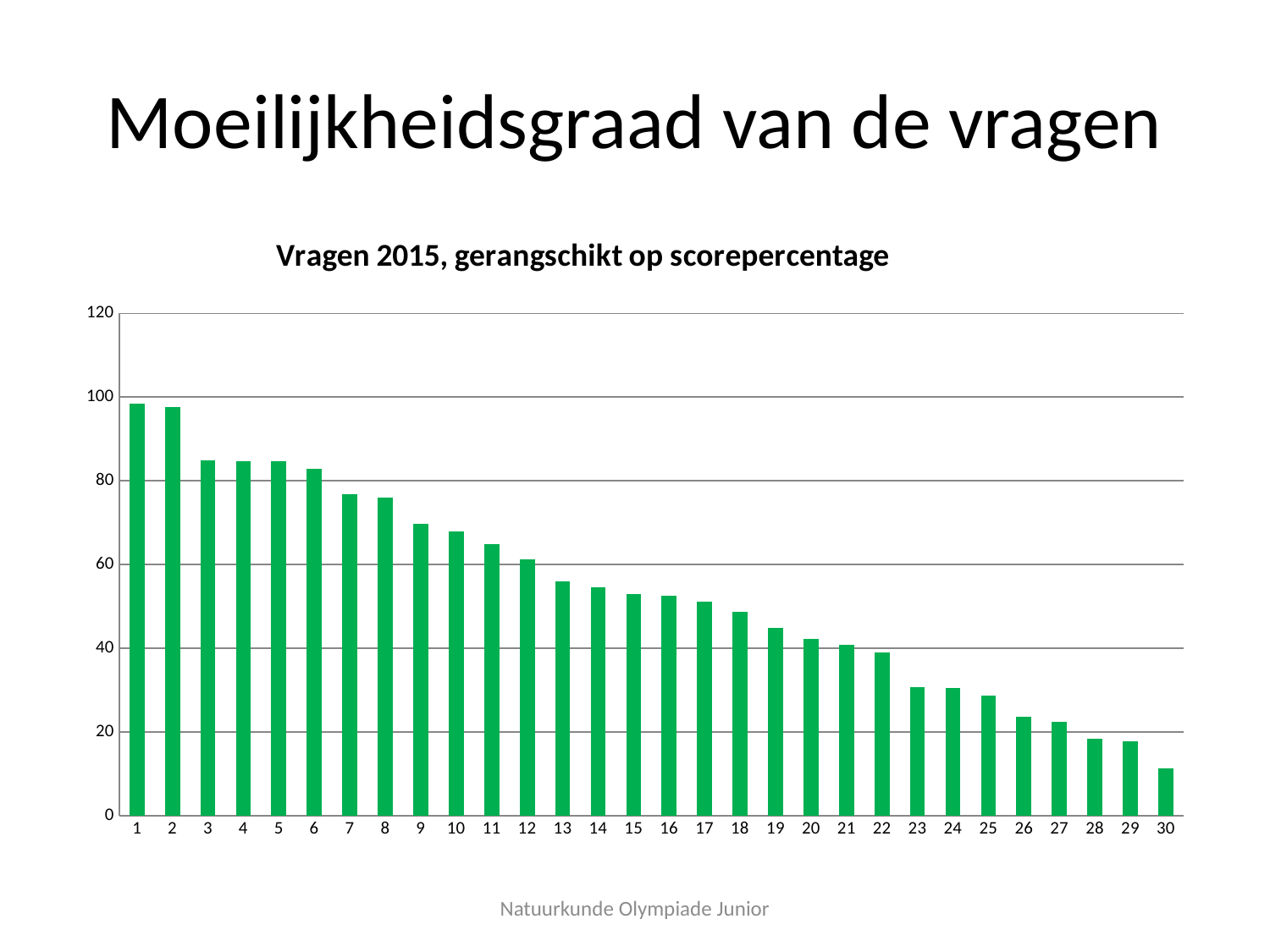
Is the value for question 1 greater or less than 80? greater Is the value for question 7 greater or less than 80? less Is the value for question 23 greater or less than 40? less Do the values rise or fall as the question number increases along the x axis? fall Which question number has the highest score percentage? 1 What kind of chart is shown on the slide? bar chart Which has the larger value, question 5 or question 20? question 5 What is the title of the chart? Vragen 2015, gerangschikt op scorepercentage How many bars (questions) are plotted in the chart? 30 Which question number has the lowest score percentage? 30